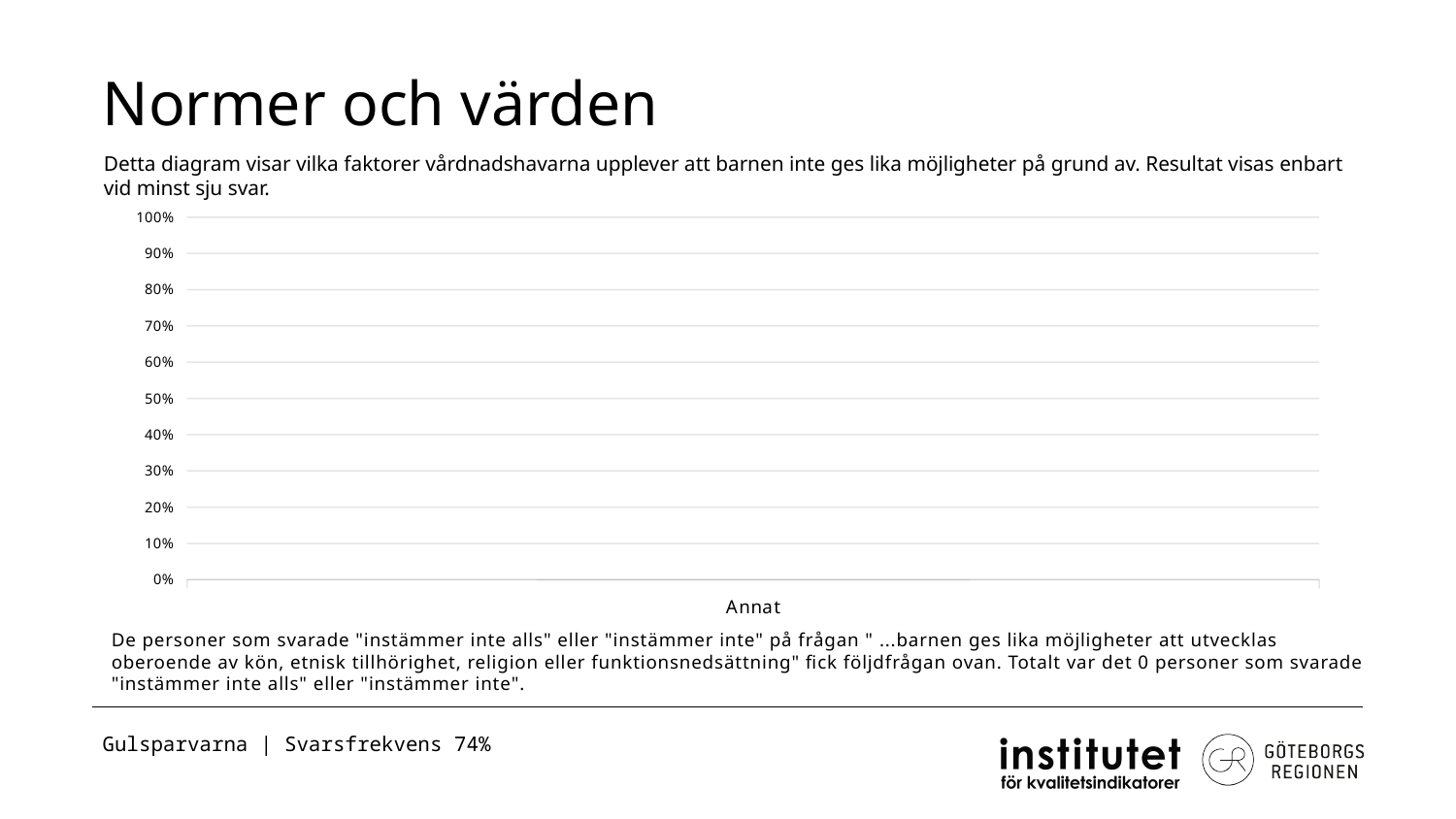
What is the title of the slide containing the chart? Normer och värden How many categories are shown on the x axis of the chart? 1 What is the lowest value shown on the y axis of the chart? 0% What is the highest value shown on the y axis of the chart? 100% What is the interval between the tick marks on the y axis of the chart? 10% What is the label of the only category on the x axis of the chart? Annat According to the text below the chart, how many people answered "instämmer inte alls" or "instämmer inte"? 0 Are any bars plotted for the category Annat in the chart? No